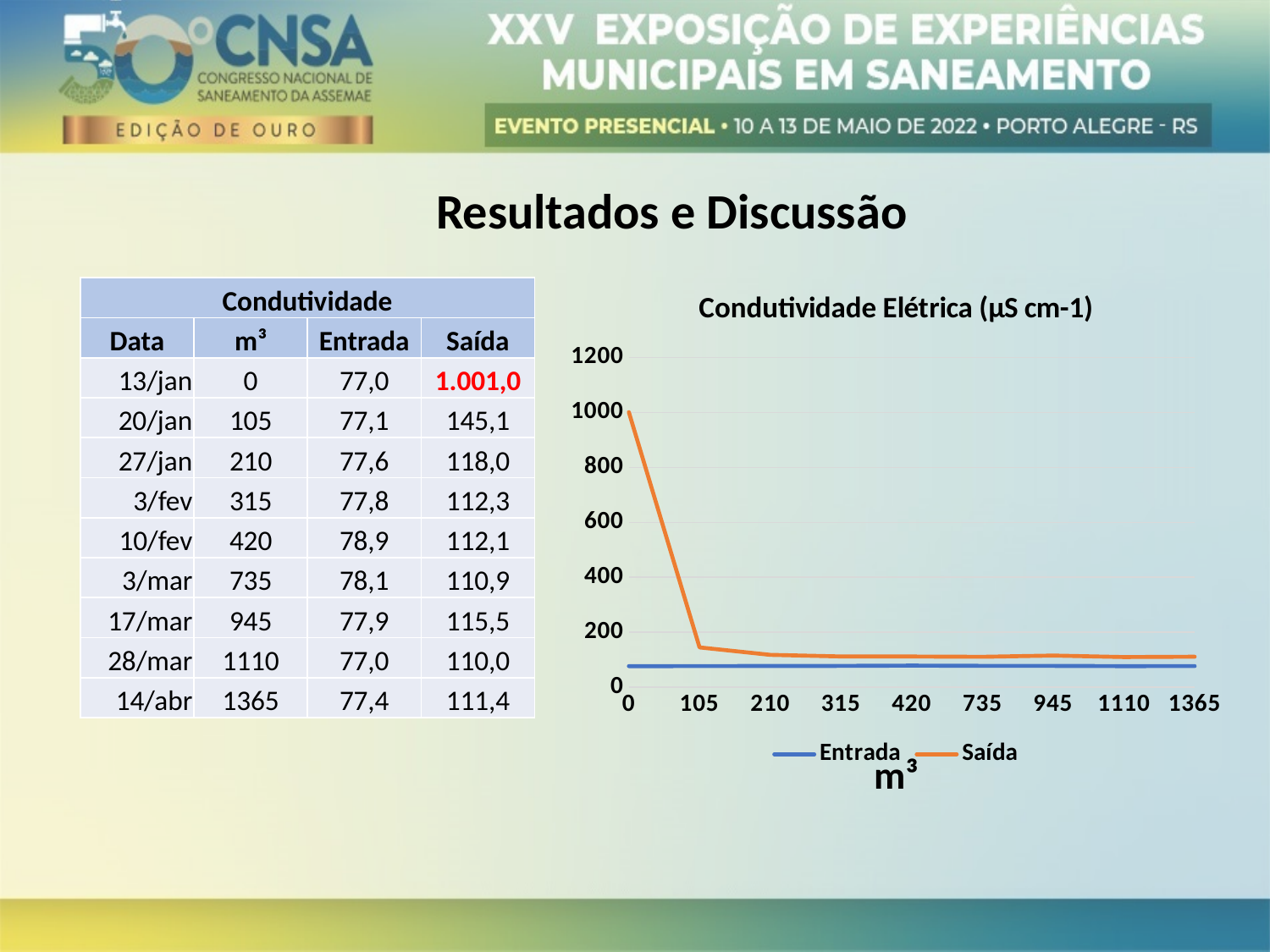
What kind of chart is shown on the slide? line chart At which x-axis value is the Saída series highest? 0 How many series does the legend of the chart list? 2 Is the value of Saída at 105 m³ greater or less than 200? less Does the Saída series rise or fall along the x axis? fall What colour is the Saída line in the chart? orange At 0 m³, which series has the larger value, Entrada or Saída? Saída What is the Saída value at 0 m³, as printed in the table on the slide? 1.001,0 What is the title of the chart? Condutividade Elétrica (μS cm-1) Is the value of Entrada at 1365 m³ greater or less than 200? less How many points are plotted along the x axis of the chart? 9 Is the value of Saída at 0 m³ greater or less than 800? greater